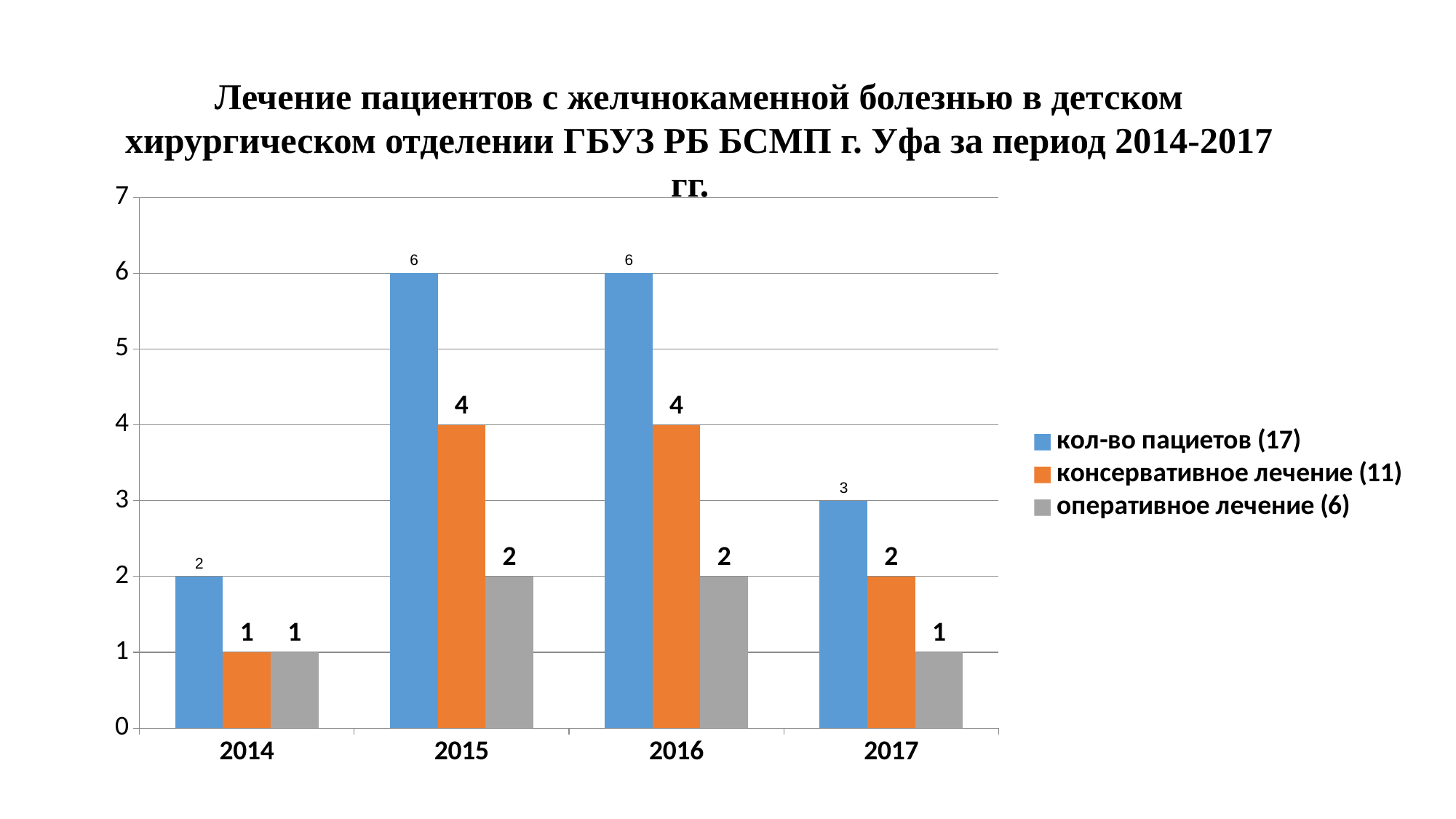
What kind of chart is shown on the slide? Bar chart What is the difference between "кол-во пациетов (17)" and "консервативное лечение (11)" in 2016? 2 Does the value for "кол-во пациетов (17)" rise or fall from 2016 to 2017? Fall What is the value for "кол-во пациетов (17)" in 2015? 6 What is the value for "консервативное лечение (11)" in 2017? 2 In which year is the value for "консервативное лечение (11)" lowest? 2014 In which year is the value for "кол-во пациетов (17)" lowest? 2014 Which is larger in 2017: "кол-во пациетов (17)" or "оперативное лечение (6)"? кол-во пациетов (17) What is the value for "оперативное лечение (6)" in 2014? 1 How many years are shown on the x axis? 4 Which colour represents "оперативное лечение (6)" in the legend? Grey How many series does the legend list? 3